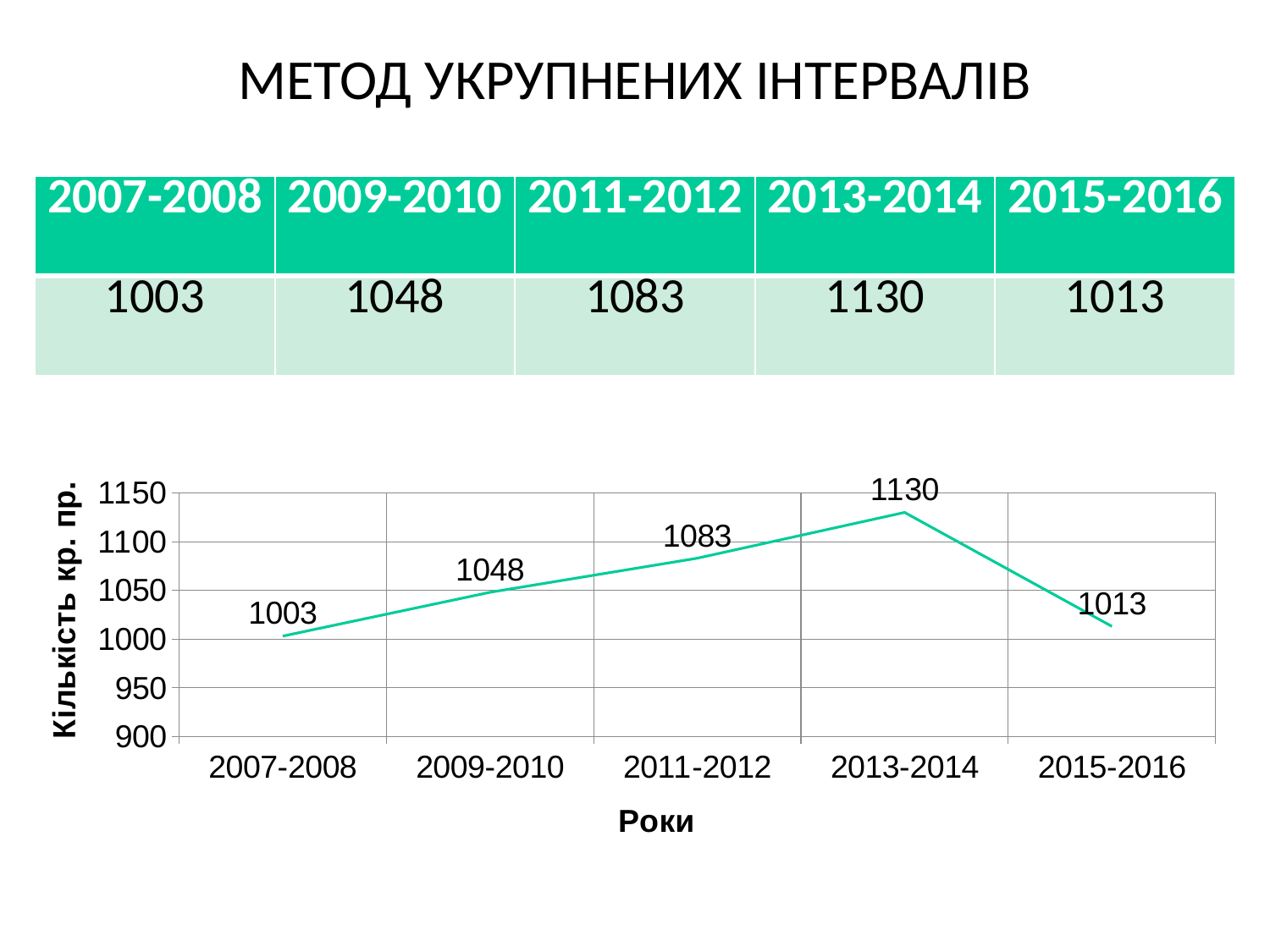
How many periods are plotted on the x axis of the chart? 5 Is the value for 2011-2012 greater or less than 1050? greater What is the value for 2013-2014 on the chart? 1130 What is the label of the x axis of the chart? Роки Which is larger, the value for 2009-2010 or the value for 2015-2016? 2009-2010 Which period has the highest value on the chart? 2013-2014 What is the value for 2015-2016 on the chart? 1013 What kind of chart is shown on the slide? line chart What is the difference between the values for 2013-2014 and 2015-2016? 117 What is the value for 2007-2008 on the chart? 1003 What is the difference between the values for 2011-2012 and 2009-2010? 35 Which period has the lowest value on the chart? 2007-2008